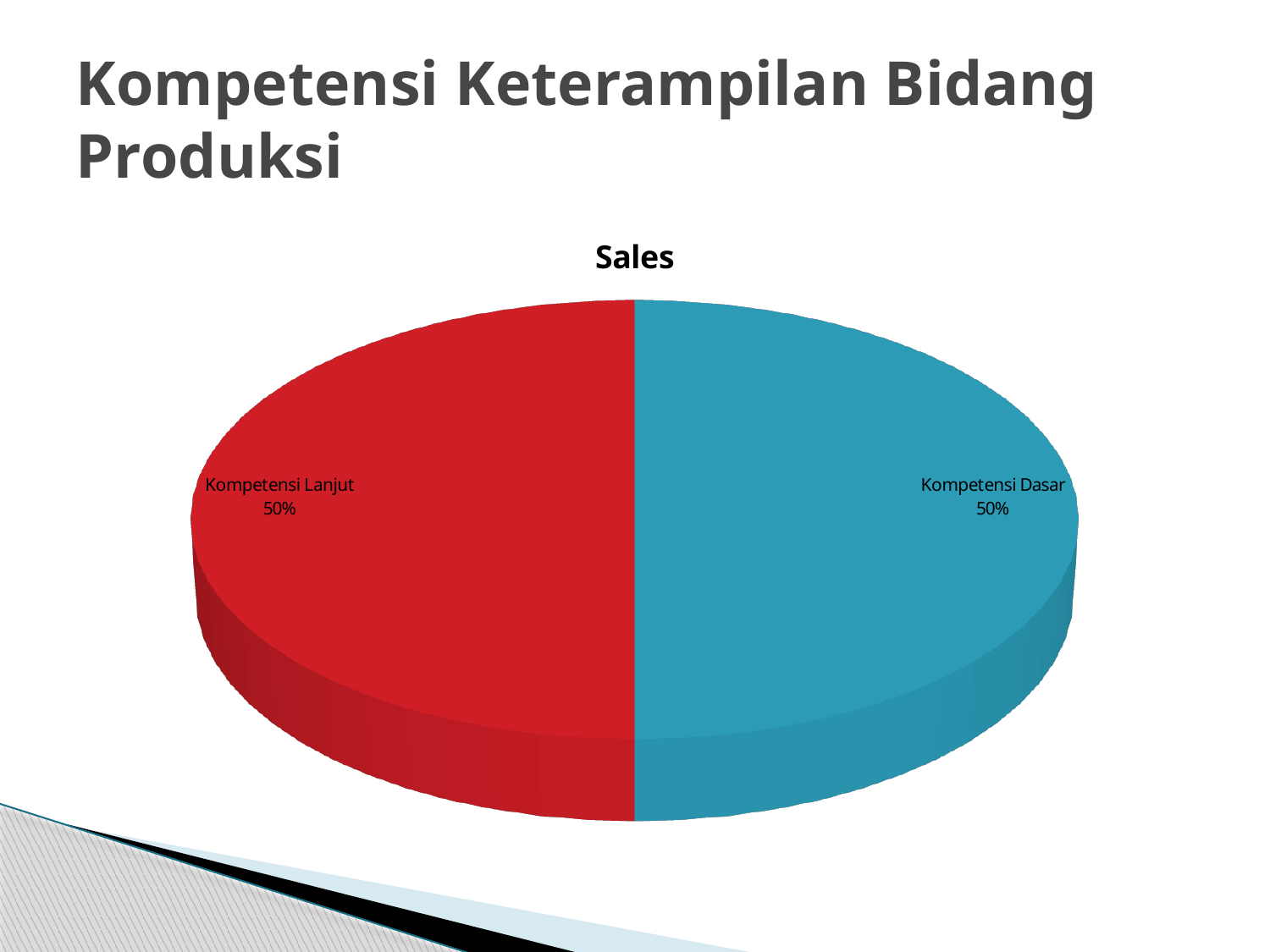
How many slices does the pie chart have? 2 What is the combined share of Kompetensi Lanjut and Kompetensi Dasar? 100% What share of the pie does Kompetensi Lanjut represent? 50% What share of the pie does Kompetensi Dasar represent? 50% What is the value shown for the Kompetensi Dasar slice? 50% What is the difference between the Kompetensi Lanjut and Kompetensi Dasar shares? 0% What is the title of the chart? Sales What colour is the Kompetensi Dasar slice? Blue What is the value shown for the Kompetensi Lanjut slice? 50% What kind of chart is shown on the slide? Pie chart